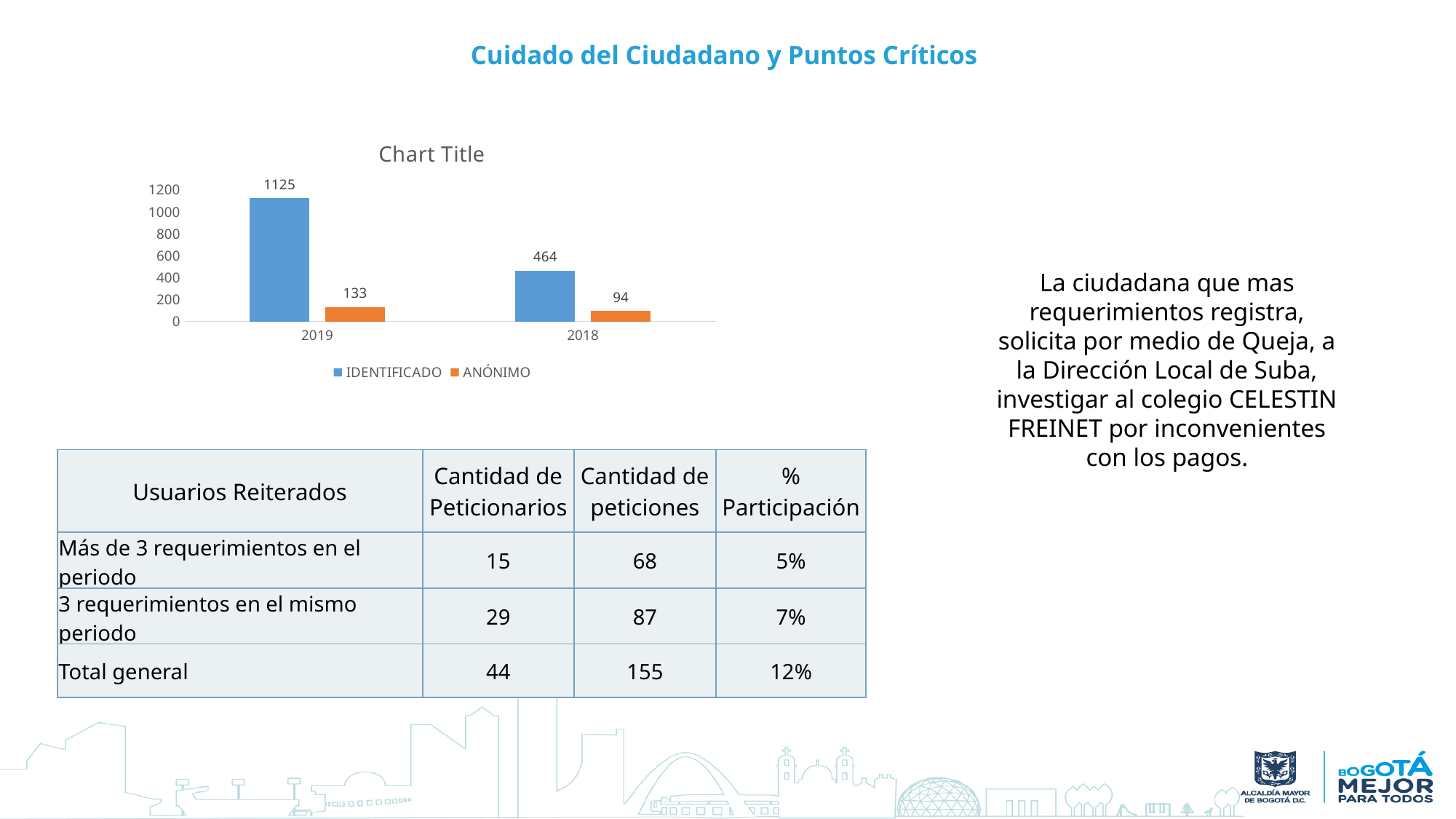
What is the value for ANÓNIMO in 2018? 94 What is the value for IDENTIFICADO in 2018? 464 What is the value for IDENTIFICADO in 2019? 1125 What is the difference between the IDENTIFICADO values for 2019 and 2018? 661 What is the value for ANÓNIMO in 2019? 133 Is the IDENTIFICADO value for 2018 greater or less than 400? greater How many years are shown on the x axis of the chart? 2 How many series does the chart legend list? 2 Which year has the highest IDENTIFICADO value? 2019 What kind of chart is shown on the slide? Bar chart Which year has the lowest ANÓNIMO value? 2018 Which is larger, the ANÓNIMO value for 2019 or for 2018? 2019